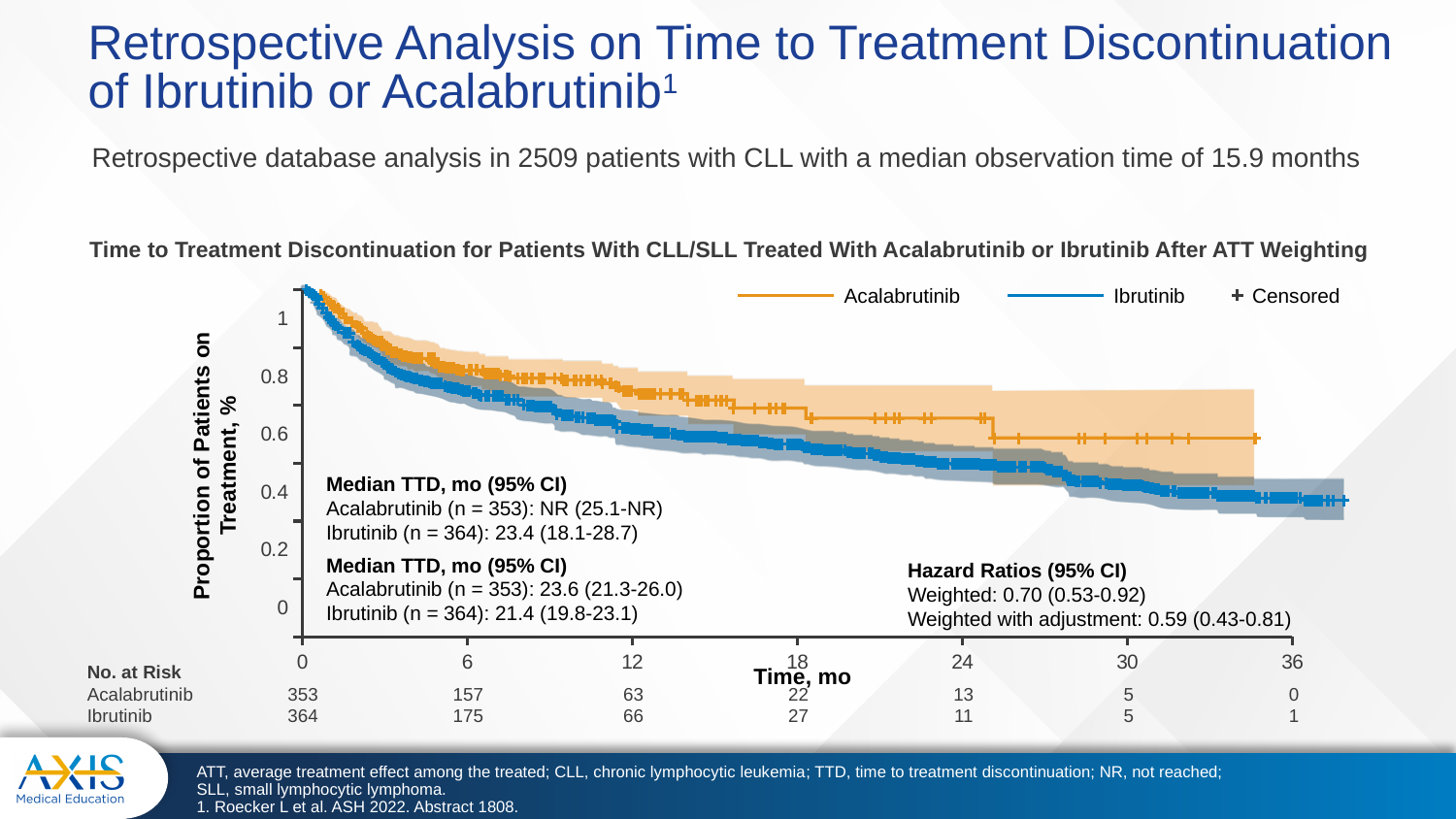
What is the difference in the number at risk at 6 months between Ibrutinib (175) and Acalabrutinib (157)? 18 What kind of chart is shown on the slide? Kaplan-Meier (survival) line chart Do the curves rise or fall as time in months increases? Fall What is the title of the chart? Time to Treatment Discontinuation for Patients With CLL/SLL Treated With Acalabrutinib or Ibrutinib After ATT Weighting How many series does the chart legend list, excluding the censored marker? 2 Is the Ibrutinib curve at 24 months greater or less than 0.6? less Which series is drawn in orange in the chart? Acalabrutinib At 24 months, which curve is higher, Acalabrutinib or Ibrutinib? Acalabrutinib How many patients were at risk in the Ibrutinib group at 36 months? 1 How many patients were at risk in the Acalabrutinib group at 12 months? 63 What is the weighted hazard ratio (95% CI) shown on the chart? 0.70 (0.53-0.92) Is the Acalabrutinib curve at 12 months greater or less than 0.6? greater